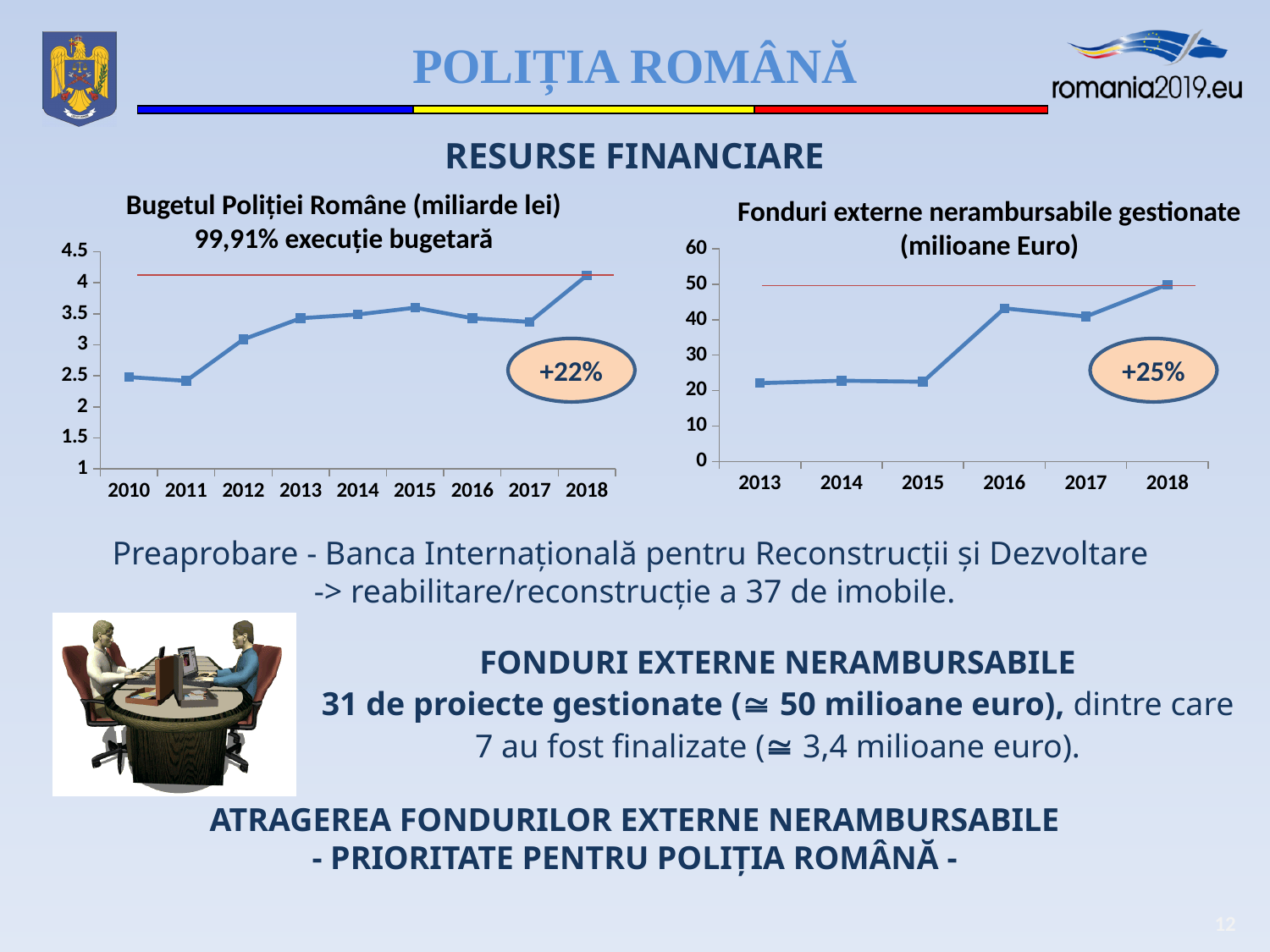
In the right chart 'Fonduri externe nerambursabile gestionate (milioane Euro)', which year has the highest value? 2018 What kind of chart is the left chart, 'Bugetul Poliției Române (miliarde lei)'? line chart In the right chart 'Fonduri externe nerambursabile gestionate', how many years are plotted on the x axis? 6 In the left chart 'Bugetul Poliției Române', is the value for 2010 greater or less than 3? less In the right chart 'Fonduri externe nerambursabile gestionate', is the value for 2013 greater or less than 30? less What percentage change is shown in the oval annotation on the right chart 'Fonduri externe nerambursabile gestionate'? +25% In the left chart 'Bugetul Poliției Române', how many years are plotted on the x axis? 9 In the left chart 'Bugetul Poliției Române', is the value for 2018 greater or less than 4? greater In the right chart 'Fonduri externe nerambursabile gestionate', which is larger, the value for 2016 or the value for 2015? 2016 In the left chart 'Bugetul Poliției Române', which year has the highest value? 2018 In the left chart 'Bugetul Poliției Române', which is larger, the value for 2012 or the value for 2011? 2012